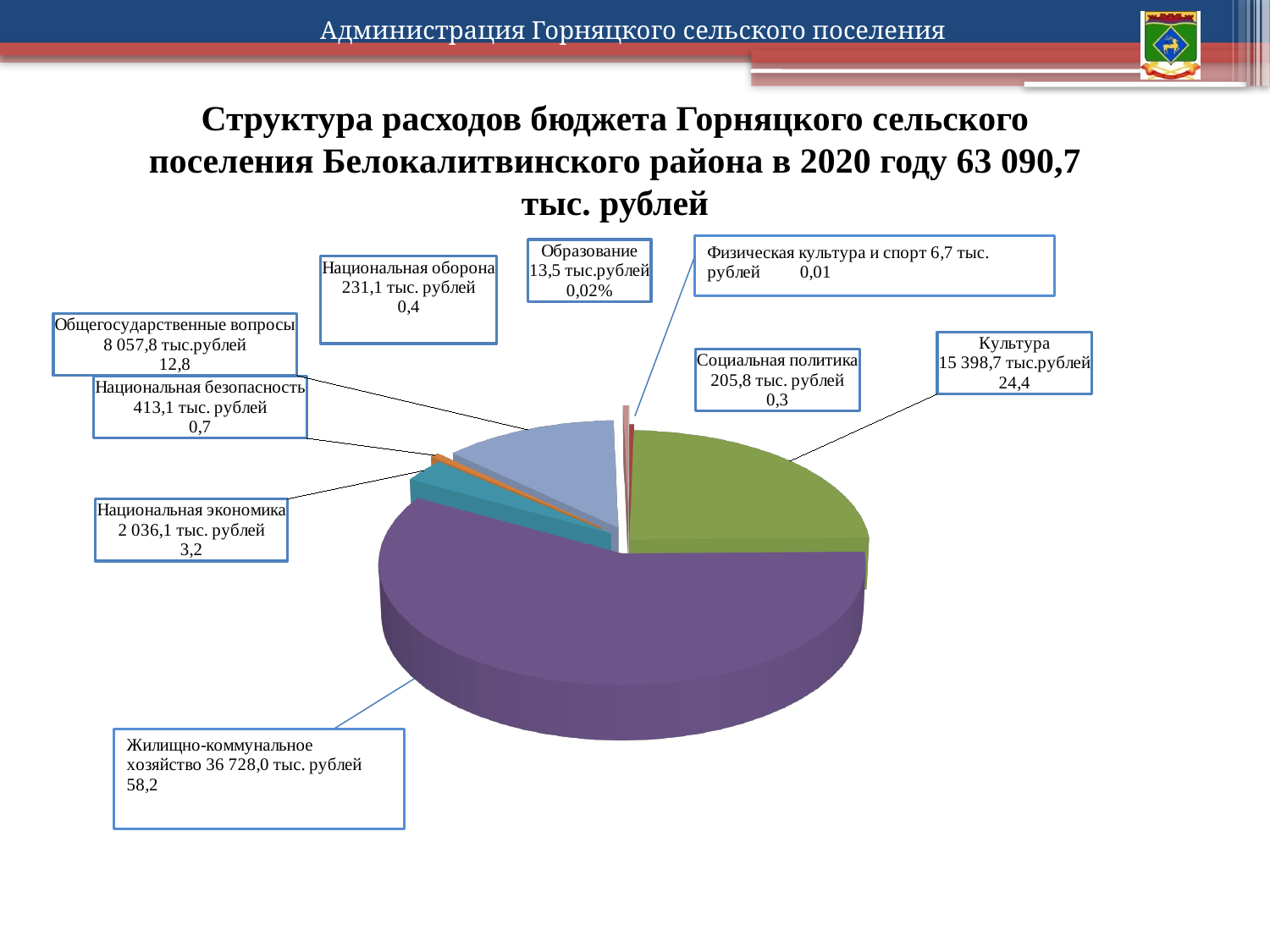
What is the amount for Социальная политика? 205,8 тыс. рублей How many expenditure categories are labelled on the pie chart? 9 What is the difference between the amounts for Национальная безопасность and Национальная оборона? 182,0 тыс. рублей Which category has the smallest amount? Физическая культура и спорт What share of the pie does Культура represent? 24,4 Which is larger: the amount for Национальная безопасность or for Национальная оборона? Национальная безопасность What kind of chart is shown on the slide? pie chart What is the amount for Национальная экономика? 2 036,1 тыс. рублей What share of the pie does Общегосударственные вопросы represent? 12,8 What is the amount for Жилищно-коммунальное хозяйство? 36 728,0 тыс. рублей What is the amount for Культура? 15 398,7 тыс.рублей Which category has the largest share of the budget expenditures? Жилищно-коммунальное хозяйство